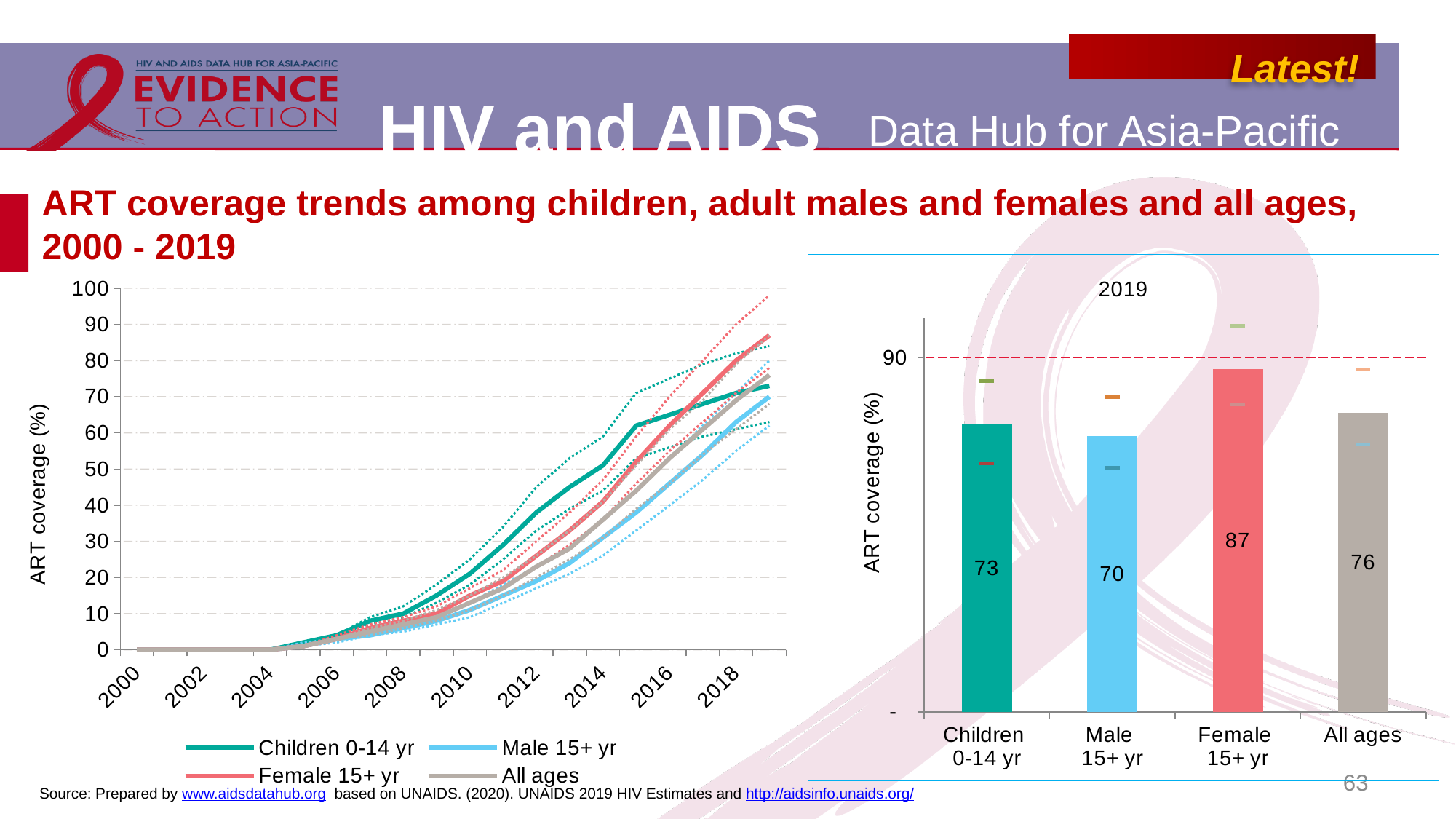
In the 2019 bar chart on the right, what is the ART coverage for Female 15+ yr? 87 How many series does the legend of the line chart on the left list? 4 In the 2019 bar chart on the right, what is the ART coverage for Children 0-14 yr? 73 In the 2019 bar chart on the right, what is the difference in ART coverage between Female 15+ yr and Male 15+ yr? 17 What kind of chart is the chart on the left? line chart In the 2019 bar chart on the right, which group has the highest ART coverage? Female 15+ yr In the line chart on the left, does ART coverage for All ages rise or fall from 2004 to 2019? rise How many groups are shown in the 2019 bar chart on the right? 4 In the 2019 bar chart on the right, which group has the lowest ART coverage? Male 15+ yr In the 2019 bar chart on the right, what is the ART coverage for Male 15+ yr? 70 In the 2019 bar chart on the right, is the ART coverage for Female 15+ yr greater or less than 90? less In the 2019 bar chart on the right, what is the ART coverage for All ages? 76